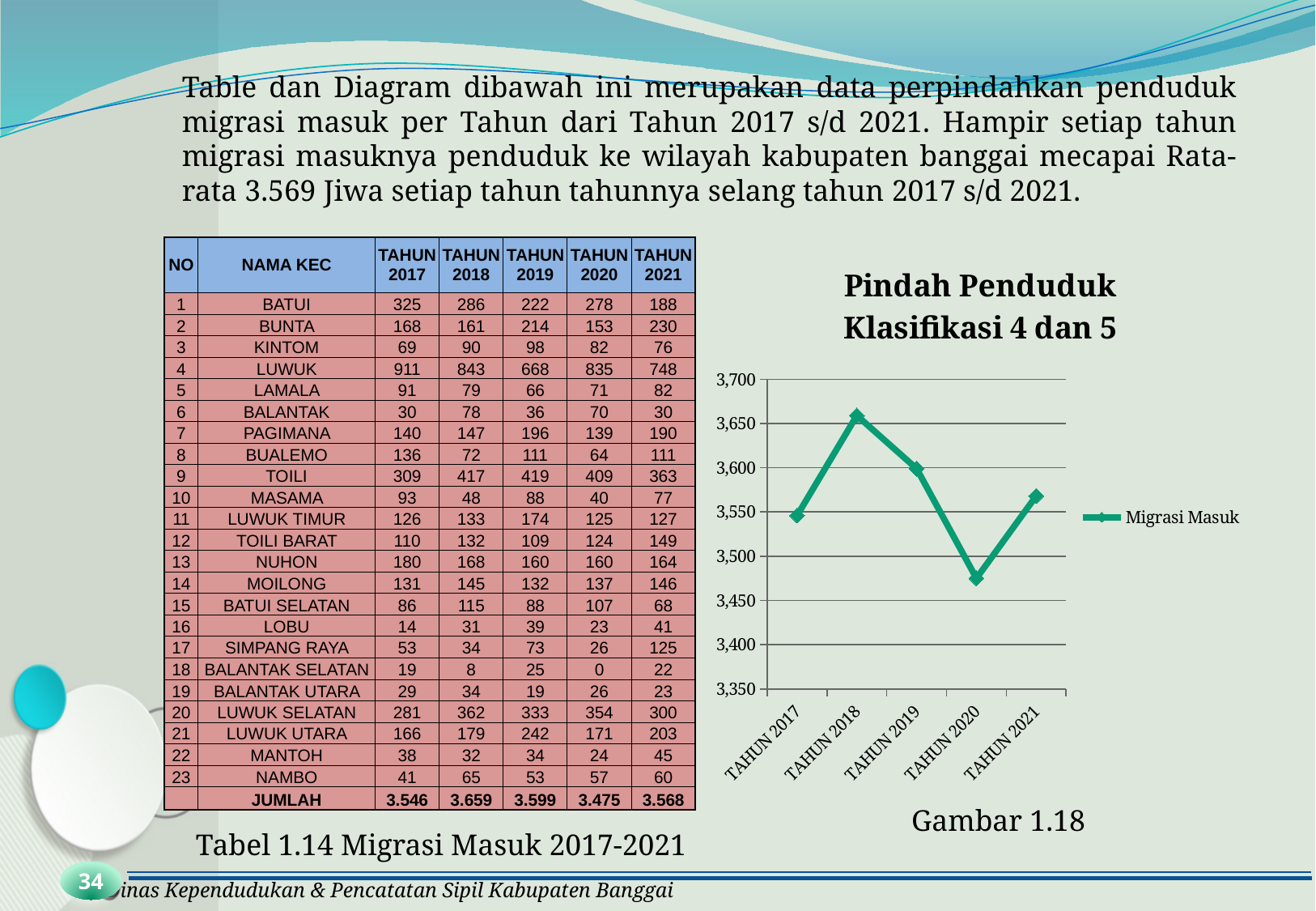
In the "Pindah Penduduk Klasifikasi 4 dan 5" chart, is the value for TAHUN 2018 greater or less than 3,600? greater In the "Pindah Penduduk Klasifikasi 4 dan 5" chart, which year has the highest value? TAHUN 2018 In the "Pindah Penduduk Klasifikasi 4 dan 5" chart, which is larger, the value for TAHUN 2017 or TAHUN 2020? TAHUN 2017 How many data points (years) are plotted on the "Pindah Penduduk Klasifikasi 4 dan 5" chart? 5 What kind of chart is shown under the title "Pindah Penduduk Klasifikasi 4 dan 5"? line chart In the "Pindah Penduduk Klasifikasi 4 dan 5" chart, is the value for TAHUN 2017 greater or less than 3,500? greater In the "Pindah Penduduk Klasifikasi 4 dan 5" chart, is the value for TAHUN 2020 greater or less than 3,500? less In the "Pindah Penduduk Klasifikasi 4 dan 5" chart, which year has the lowest value? TAHUN 2020 How many series does the legend of the "Pindah Penduduk Klasifikasi 4 dan 5" chart list? 1 In the "Pindah Penduduk Klasifikasi 4 dan 5" chart, which is larger, the value for TAHUN 2018 or TAHUN 2019? TAHUN 2018 In the "Pindah Penduduk Klasifikasi 4 dan 5" chart, do the values rise or fall from TAHUN 2018 to TAHUN 2020? fall What is the name of the series shown in the legend of the "Pindah Penduduk Klasifikasi 4 dan 5" chart? Migrasi Masuk